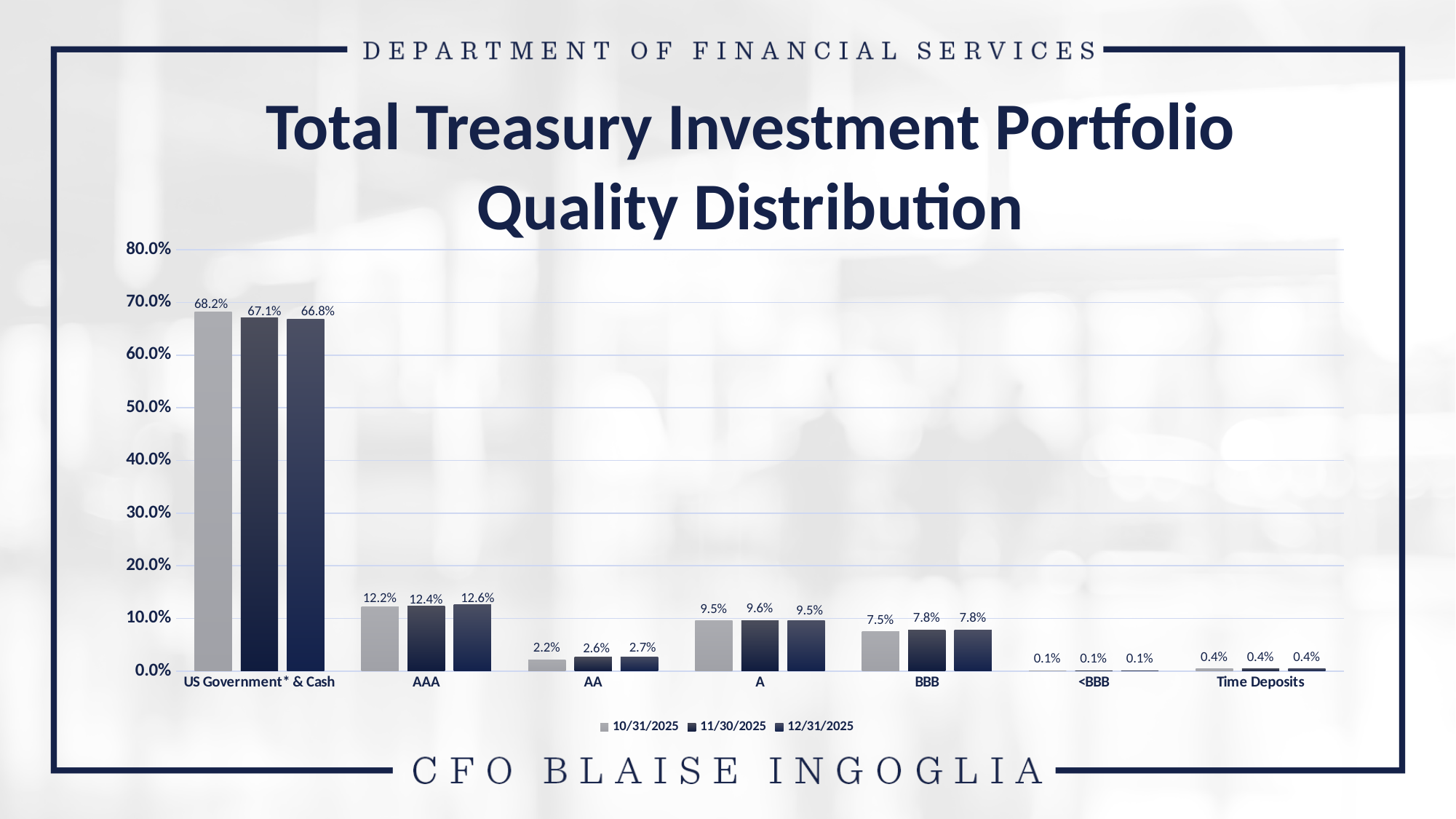
What is the value for AAA in the 12/31/2025 series? 12.6% How many series does the legend list? 3 What is the value for US Government* & Cash in the 10/31/2025 series? 68.2% How many categories are shown on the x axis? 7 Is the 11/30/2025 value for US Government* & Cash greater or less than 60.0%? greater What is the value for BBB in the 10/31/2025 series? 7.5% What is the difference between the 10/31/2025 and 12/31/2025 values for US Government* & Cash? 1.4% What is the value for AA in the 11/30/2025 series? 2.6% What kind of chart is shown on the slide? Bar chart Which category has the highest value in the 12/31/2025 series? US Government* & Cash Which is larger: the 12/31/2025 value for A or the 12/31/2025 value for BBB? A Which category has the lowest value in the 10/31/2025 series? <BBB